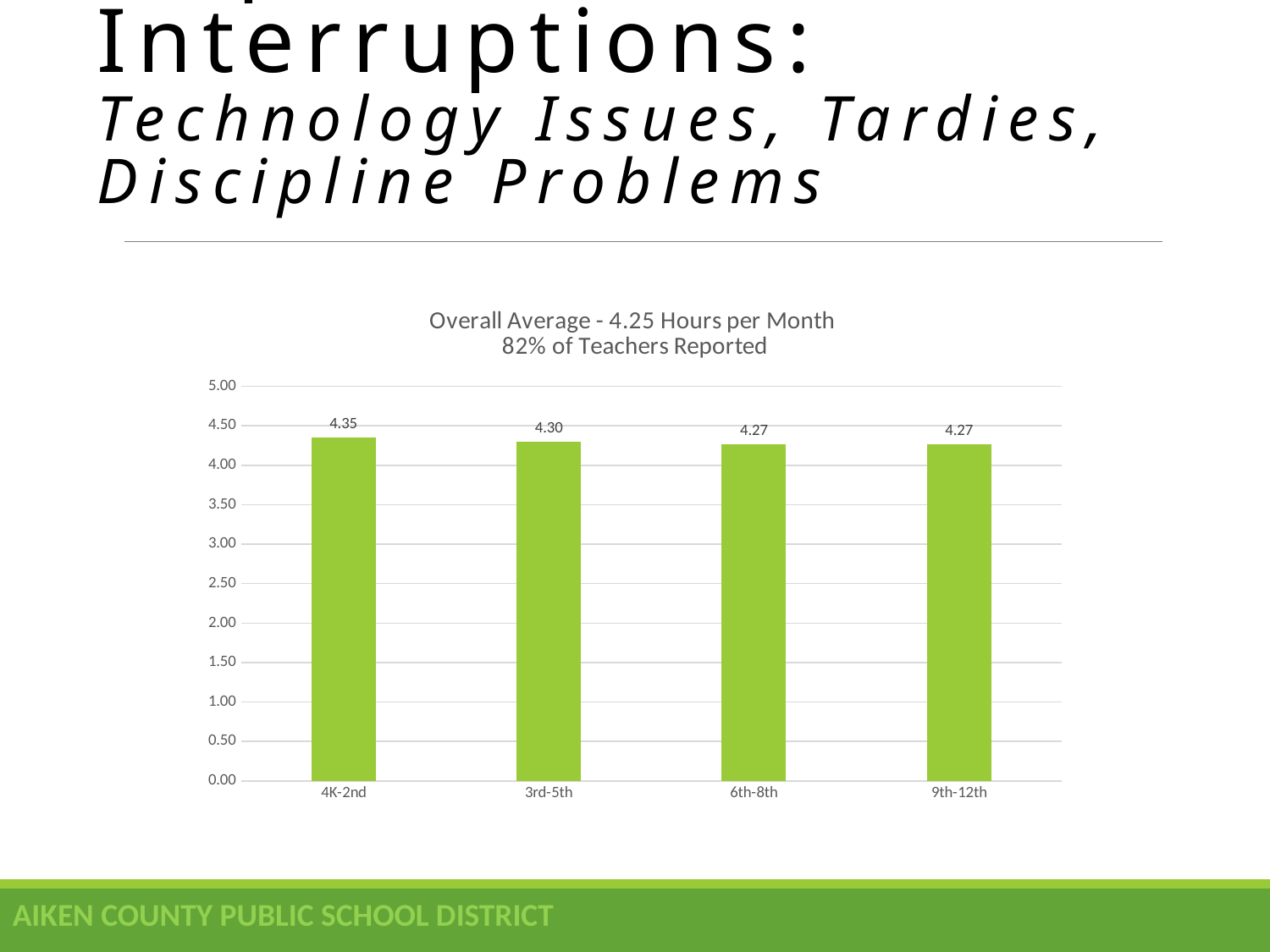
What is the chart's title? Overall Average - 4.25 Hours per Month 82% of Teachers Reported Is the value for 3rd-5th greater or less than 4.00? greater What is the value for 9th-12th? 4.27 What is the value for 3rd-5th? 4.30 Which grade band has the highest value? 4K-2nd How many grade bands are shown on the x axis? 4 What is the difference between the values for 4K-2nd and 9th-12th? 0.08 What is the value for 6th-8th? 4.27 What kind of chart is shown on the slide? bar chart What is the value for 4K-2nd? 4.35 What is the difference between the values for 4K-2nd and 3rd-5th? 0.05 Which is larger, the value for 4K-2nd or the value for 6th-8th? 4K-2nd